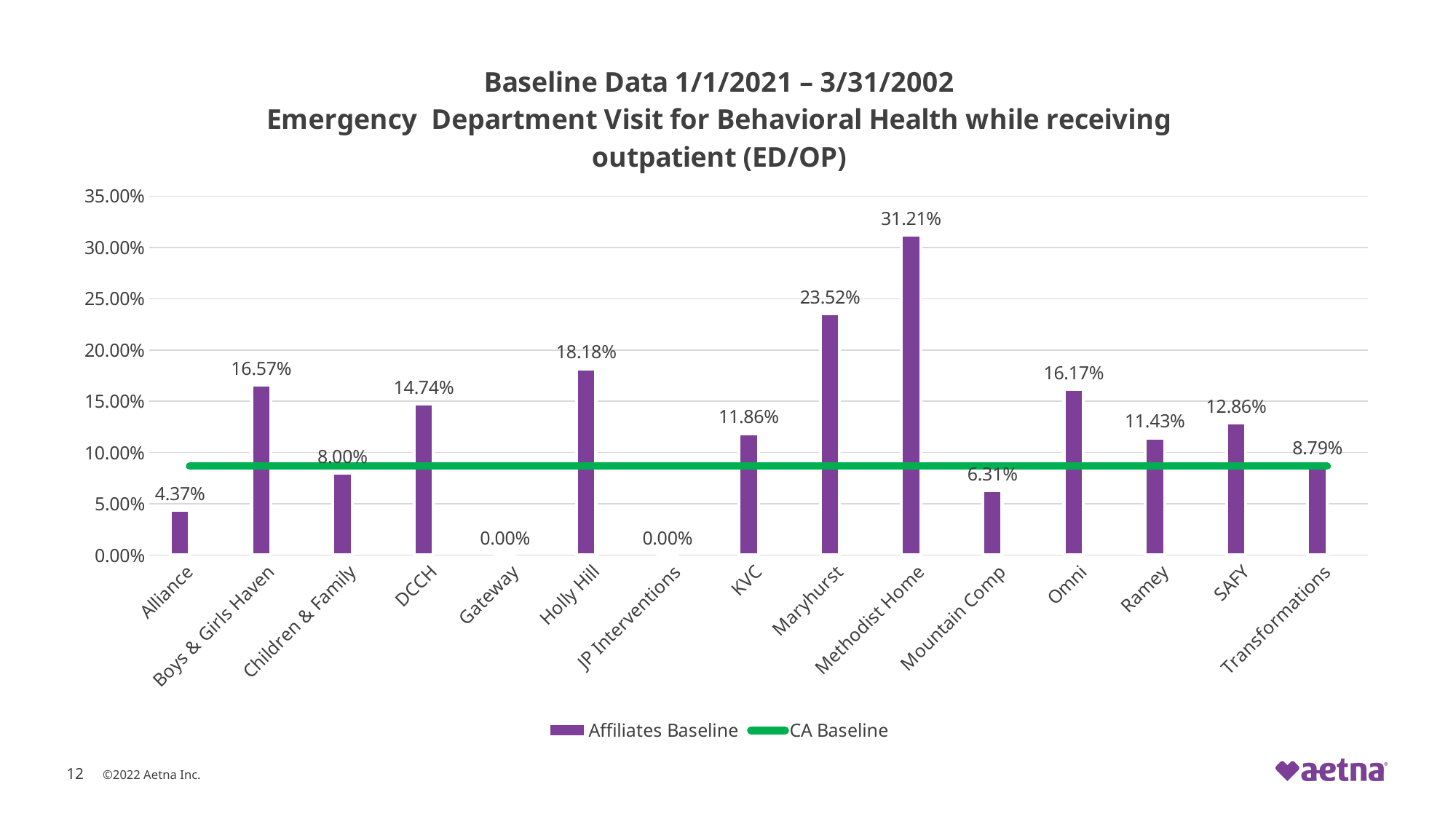
What is the Affiliates Baseline value for Mountain Comp? 6.31% Which affiliate has the highest Affiliates Baseline value? Methodist Home What is the Affiliates Baseline value for Methodist Home? 31.21% What is the Affiliates Baseline value for Holly Hill? 18.18% How many series does the legend list? 2 Is the Affiliates Baseline value for Maryhurst greater or less than 20.00%? greater Which has a larger Affiliates Baseline value, Boys & Girls Haven or Omni? Boys & Girls Haven How many affiliates are shown on the x axis? 15 Which affiliates have an Affiliates Baseline value of 0.00%? Gateway and JP Interventions What kind of chart is used to show the Affiliates Baseline values? Bar chart Which affiliate has the lowest non-zero Affiliates Baseline value? Alliance What is the difference between the Affiliates Baseline values for Methodist Home and Maryhurst? 7.69%